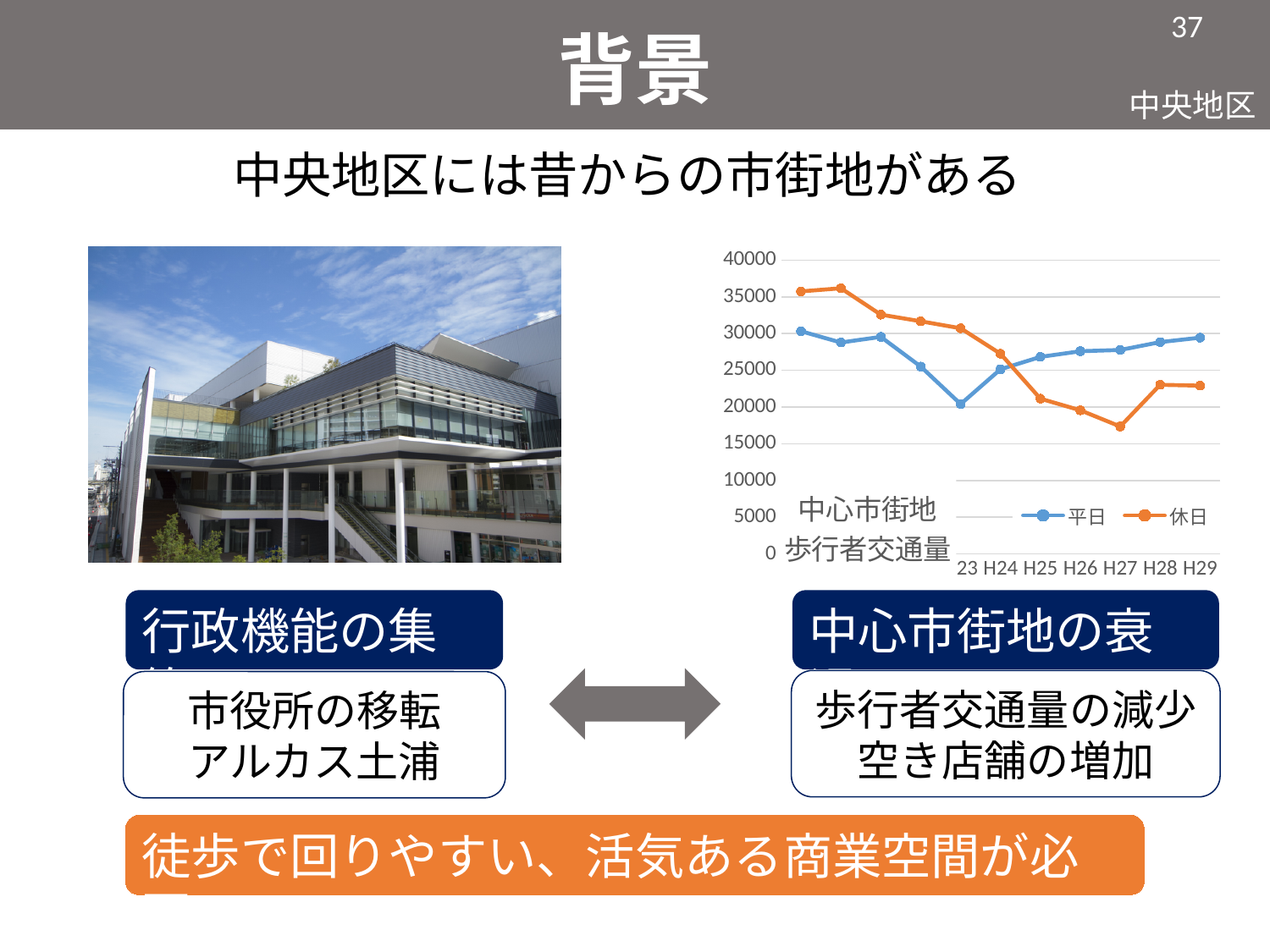
What kind of chart is shown on the slide? line chart How many series does the chart's legend list? 2 What are the two series named in the chart's legend? 平日 and 休日 What is the maximum value shown on the chart's vertical axis? 40000 Overall, does the 休日 line rise or fall from left to right? fall Is the 休日 value at the rightmost point greater or less than 25000? less Which series has the higher value at the leftmost point of the chart, 平日 or 休日? 休日 Which series has the higher value at the rightmost point of the chart, 平日 or 休日? 平日 Is the lowest value of the 休日 series greater or less than 20000? less Which series reaches the lowest point anywhere on the chart, 平日 or 休日? 休日 Is the highest value of the 休日 series greater or less than 35000? greater